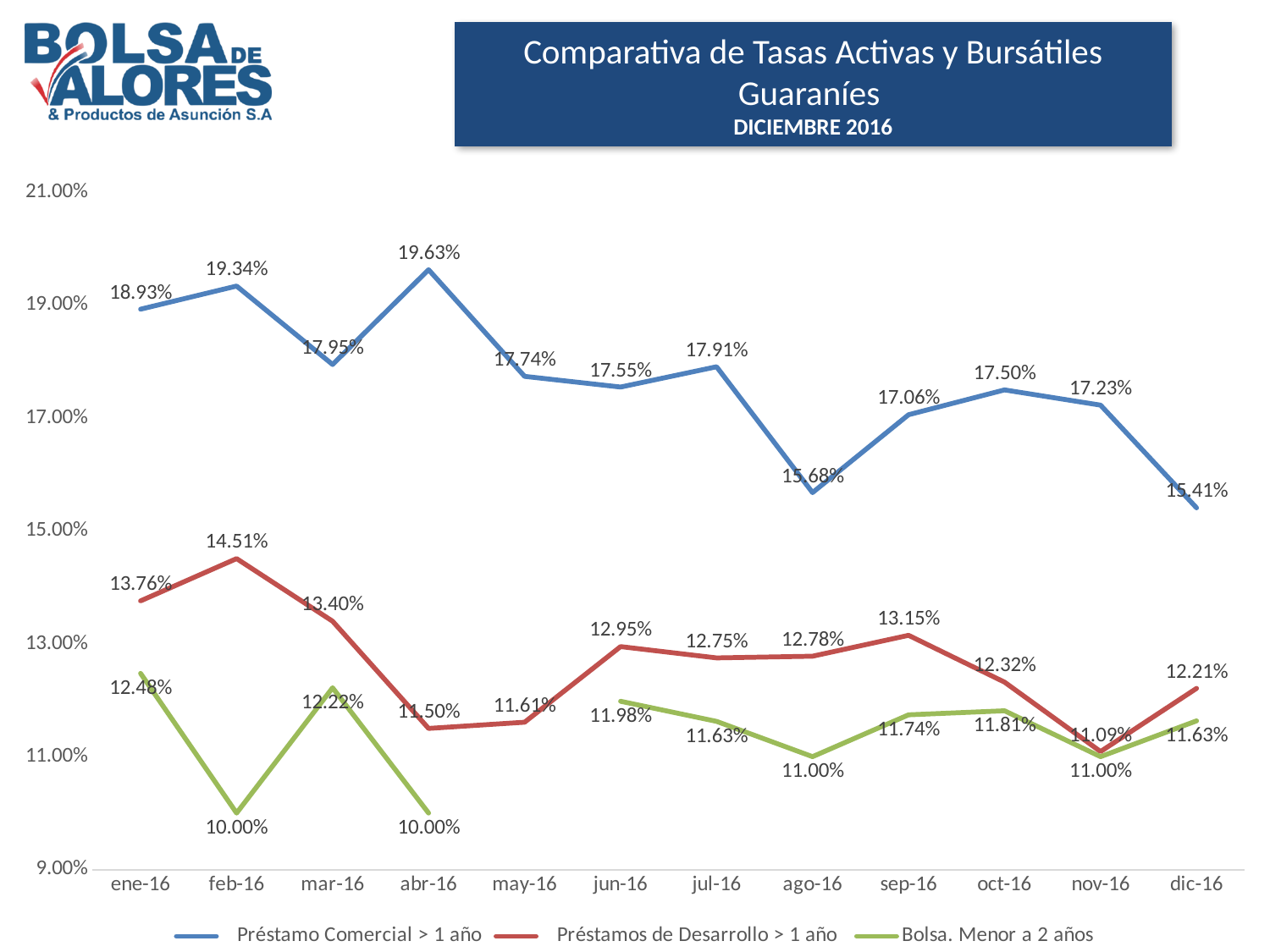
What is the title of the chart? Comparativa de Tasas Activas y Bursátiles Guaraníes How many months are shown on the x axis? 12 Does Préstamo Comercial > 1 año generally rise or fall from ene-16 to dic-16? fall What is the value for Préstamos de Desarrollo > 1 año in sep-16? 13.15% What is the value for Préstamo Comercial > 1 año in abr-16? 19.63% How many series does the legend list? 3 What is the value for Bolsa. Menor a 2 años in jun-16? 11.98% In which month is Préstamos de Desarrollo > 1 año at its highest? feb-16 What is the difference between Préstamo Comercial > 1 año in ene-16 and dic-16? 3.52% Which is larger in mar-16: Préstamos de Desarrollo > 1 año or Bolsa. Menor a 2 años? Préstamos de Desarrollo > 1 año In which month is Préstamo Comercial > 1 año at its lowest? dic-16 What type of chart is shown on the slide? line chart